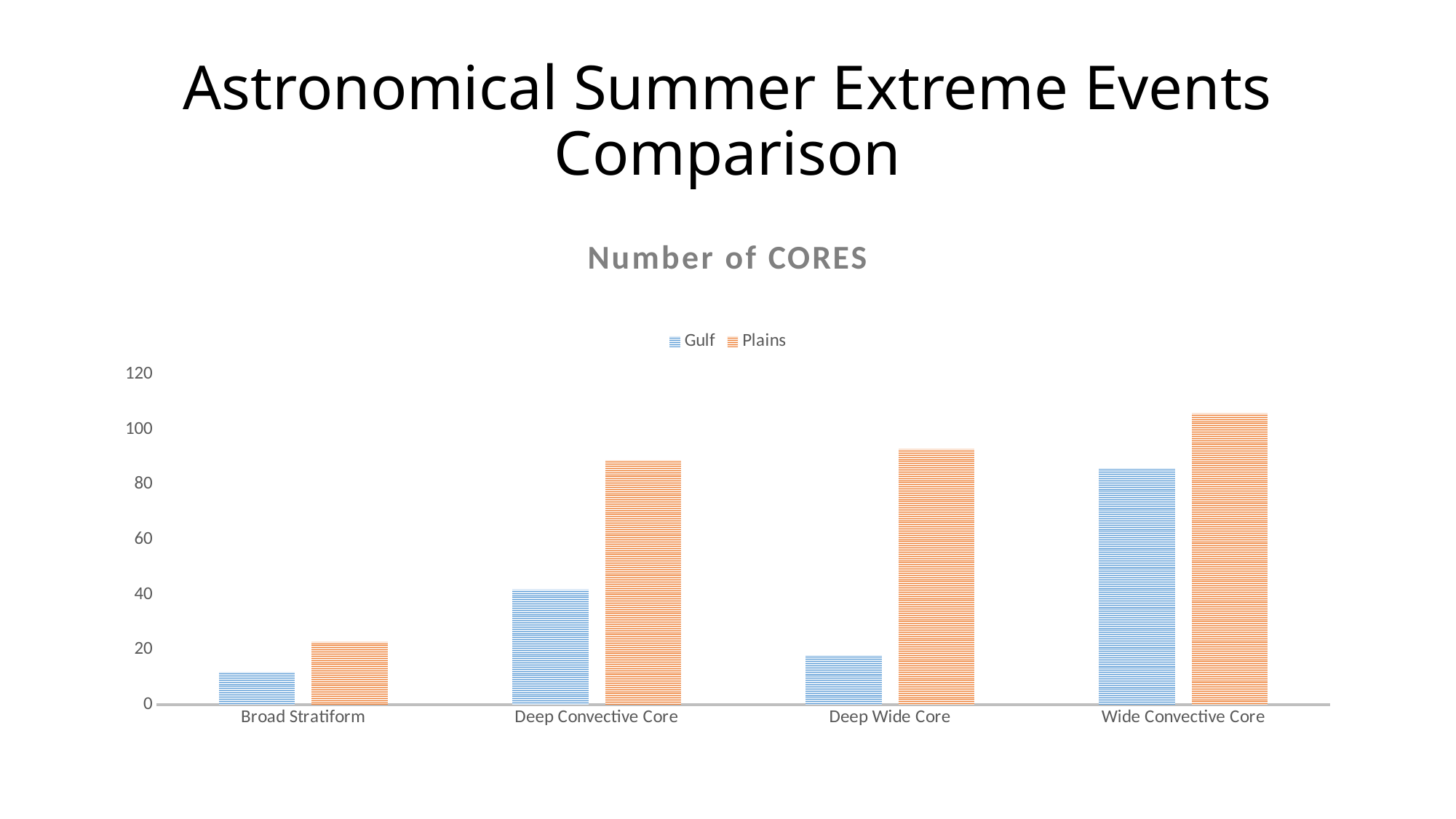
What kind of chart is shown on the slide? bar chart Is the Gulf value for Deep Wide Core greater or less than 40? less For Deep Wide Core, which series has the larger value, Gulf or Plains? Plains Is the Plains value for Deep Convective Core greater or less than 80? greater Is the Plains value for Wide Convective Core greater or less than 100? greater How many series does the legend list? 2 What is the title of the chart? Number of CORES Which category has the highest Plains value? Wide Convective Core Which category has the highest Gulf value? Wide Convective Core Which category has the lowest Gulf value? Broad Stratiform How many categories are shown on the x axis? 4